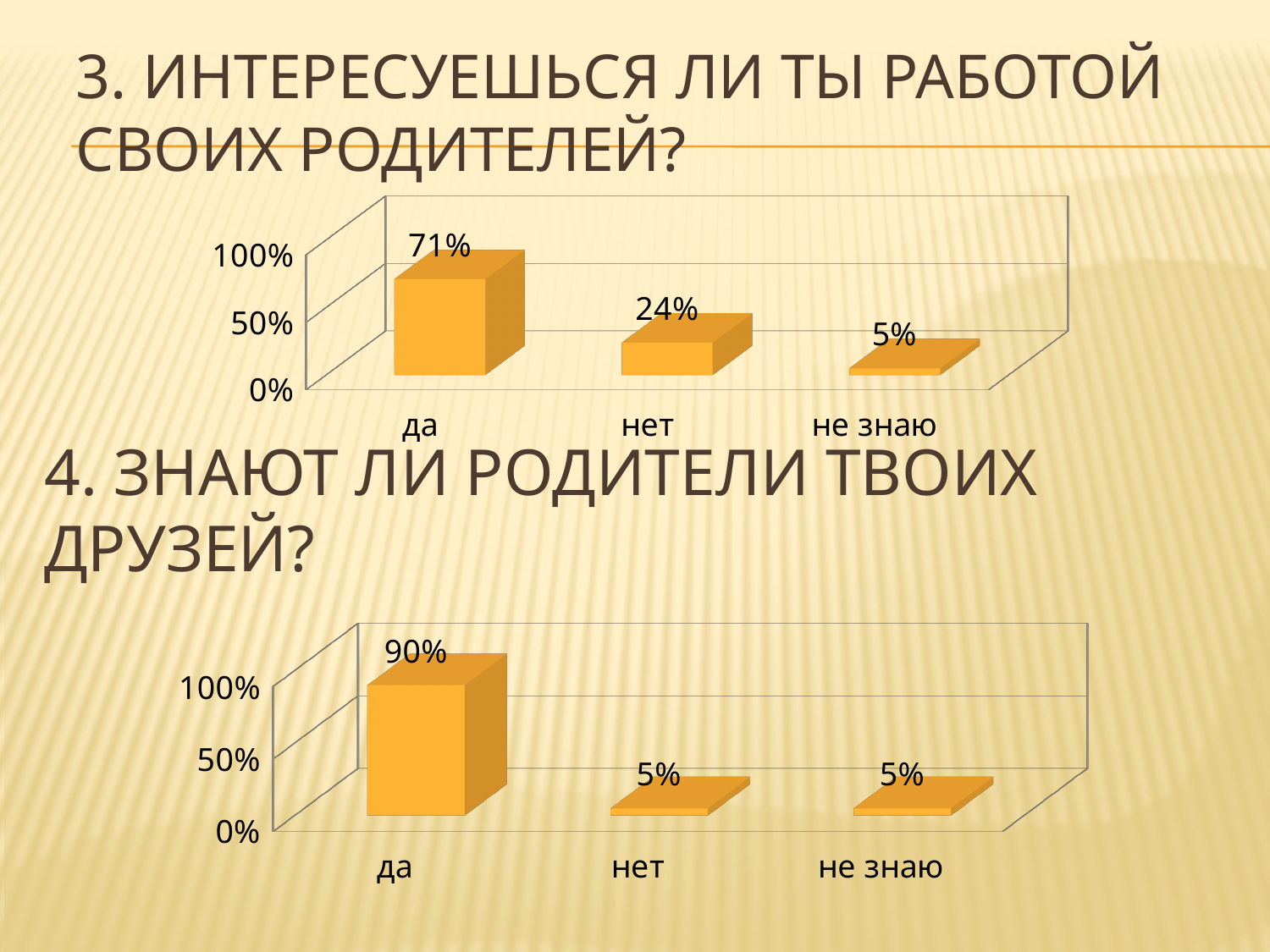
In the top chart (question 3), what is the value for "не знаю"? 5% In the top chart (question 3), which category has the highest value? да In the top chart (question 3), what is the value for "нет"? 24% In the bottom chart (question 4, about parents knowing friends), what is the value for "да"? 90% What kind of chart is the bottom chart (question 4)? bar chart In the top chart (question 3), how many categories are shown? 3 In the top chart (question 3), what is the difference between "да" and "нет"? 47% Which is larger: the value for "да" in the top chart or the value for "да" in the bottom chart? the bottom chart (90%) In the bottom chart (question 4), which category has the highest value? да In the bottom chart (question 4), what is the difference between "да" and "не знаю"? 85% In the top chart (question 3, about interest in parents' work), what is the value for "да"? 71% In the bottom chart (question 4), what is the value for "нет"? 5%